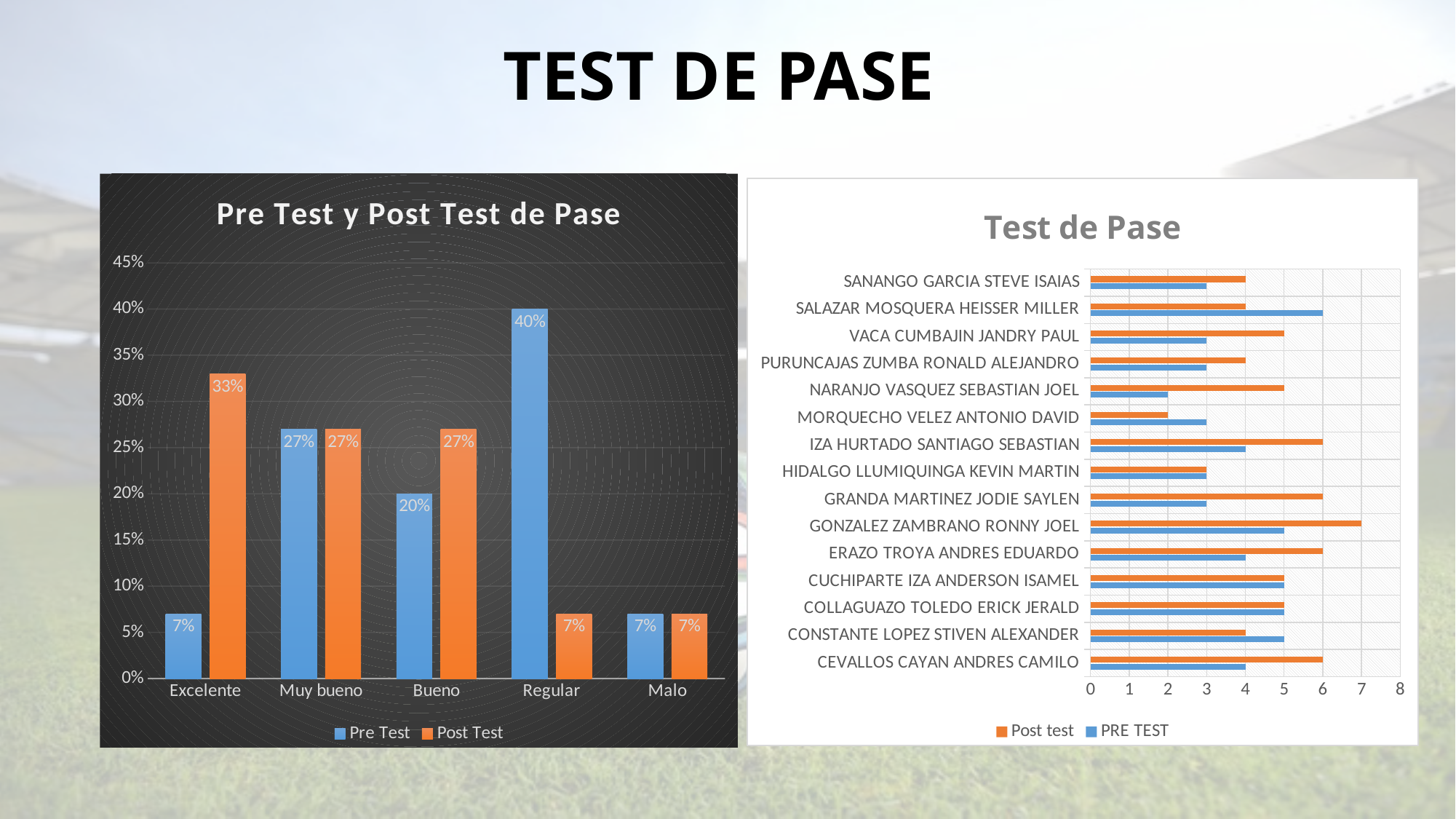
In the chart titled 'Test de Pase', what is the Post test value for GONZALEZ ZAMBRANO RONNY JOEL? 7 In the chart titled 'Pre Test y Post Test de Pase', what is the Post Test value for Excelente? 33% In the chart titled 'Test de Pase', what colour are the Post test bars? Orange In the chart titled 'Pre Test y Post Test de Pase', how many categories are shown on the x axis? 5 In the chart titled 'Test de Pase', which student has the highest Post test value? GONZALEZ ZAMBRANO RONNY JOEL In the chart titled 'Test de Pase', is the Post test value for IZA HURTADO SANTIAGO SEBASTIAN greater or less than 5? greater What kind of chart is the chart titled 'Test de Pase' on the right? Bar chart In the chart titled 'Pre Test y Post Test de Pase', what is the Pre Test value for Regular? 40% In the chart titled 'Pre Test y Post Test de Pase', how many series does the legend list? 2 In the chart titled 'Pre Test y Post Test de Pase', what is the difference between the Post Test and Pre Test values for Excelente? 26% In the chart titled 'Pre Test y Post Test de Pase', which category has the highest Pre Test value? Regular In the chart titled 'Pre Test y Post Test de Pase', which is larger for Bueno: the Pre Test or the Post Test value? Post Test